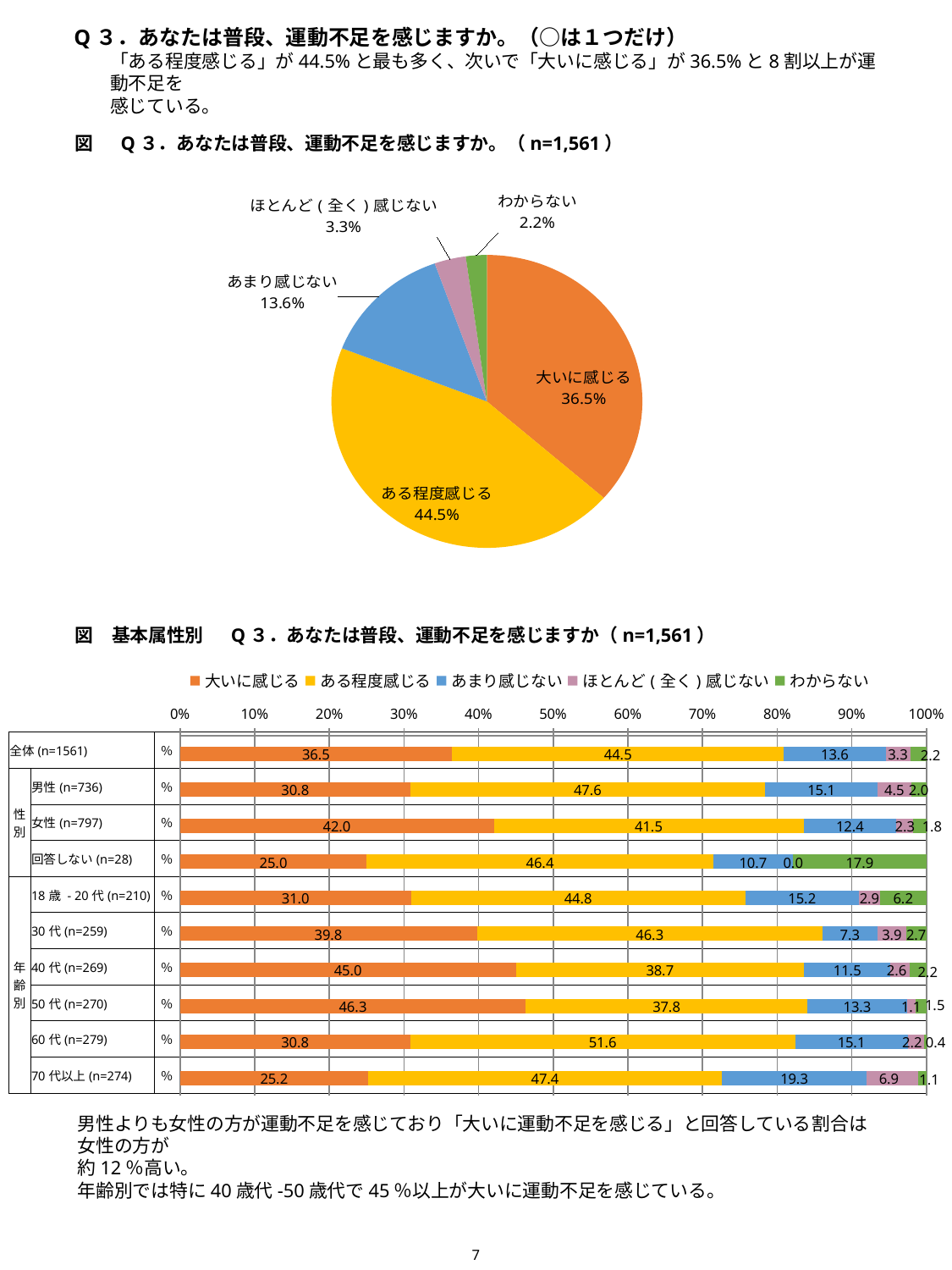
In the pie chart, which response has the largest share? ある程度感じる In the stacked bar chart by attribute, how many category rows are plotted? 10 In the pie chart, what percentage of respondents answered 「ある程度感じる」? 44.5% In the pie chart, how many slices are there? 5 In the stacked bar chart by attribute, what is the value of 「わからない」 for 回答しない (n=28)? 17.9 In the stacked bar chart by attribute, which category has the highest value for 「ある程度感じる」? 60代 (n=279) In the stacked bar chart by attribute, what is the value of 「大いに感じる」 for 女性 (n=797)? 42.0 In the stacked bar chart by attribute, which is larger: the 「大いに感じる」 value for 男性 (n=736) or for 女性 (n=797)? 女性 (n=797) In the pie chart, what is the difference between the shares of 「大いに感じる」 and 「あまり感じない」? 22.9% In the pie chart, which response has the smallest share? わからない In the stacked bar chart by attribute, how many series does the legend list? 5 What type of chart is the upper chart on the slide? Pie chart